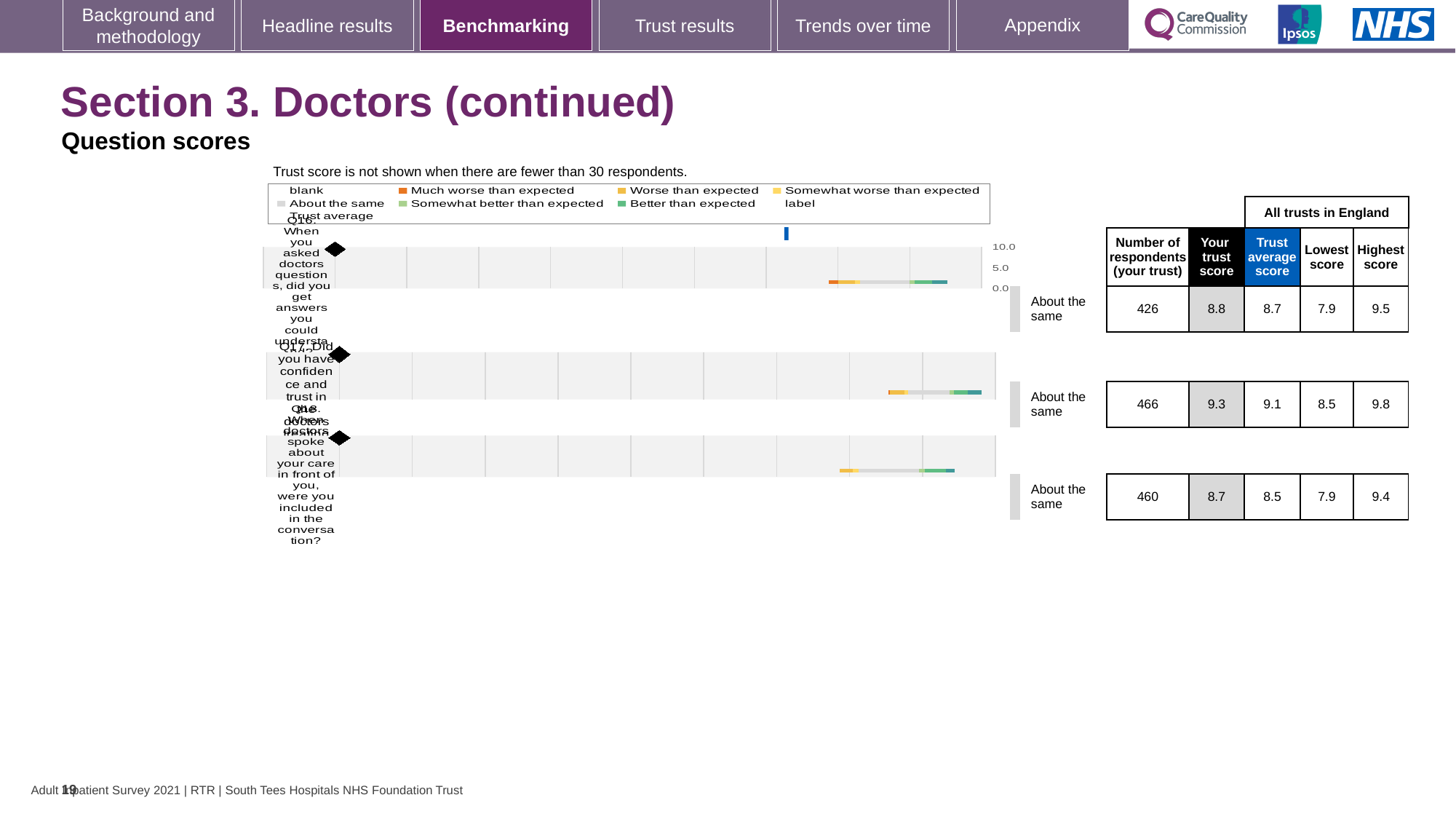
For Q16, which is larger: the 'Your trust score' or the trust average score? Your trust score What is the difference between the 'Your trust score' and the trust average score for Q17? 0.2 How many respondents from your trust answered Q18? 460 Which question has the highest 'Your trust score'? Q17 What is the trust average score for Q17 (Did you have confidence and trust in the doctors treating you)? 9.1 How many questions (categories) are plotted in the chart? 3 What is the 'Your trust score' for Q16 (When you asked doctors questions, did you get answers you could understand)? 8.8 What kind of chart is used to show the question scores on this slide? Bar chart What is the lowest score among all trusts in England for Q18? 7.9 Which question has the lowest 'Your trust score'? Q18 What benchmark category is shown next to each of the three questions? About the same What is the highest score among all trusts in England for Q16? 9.5